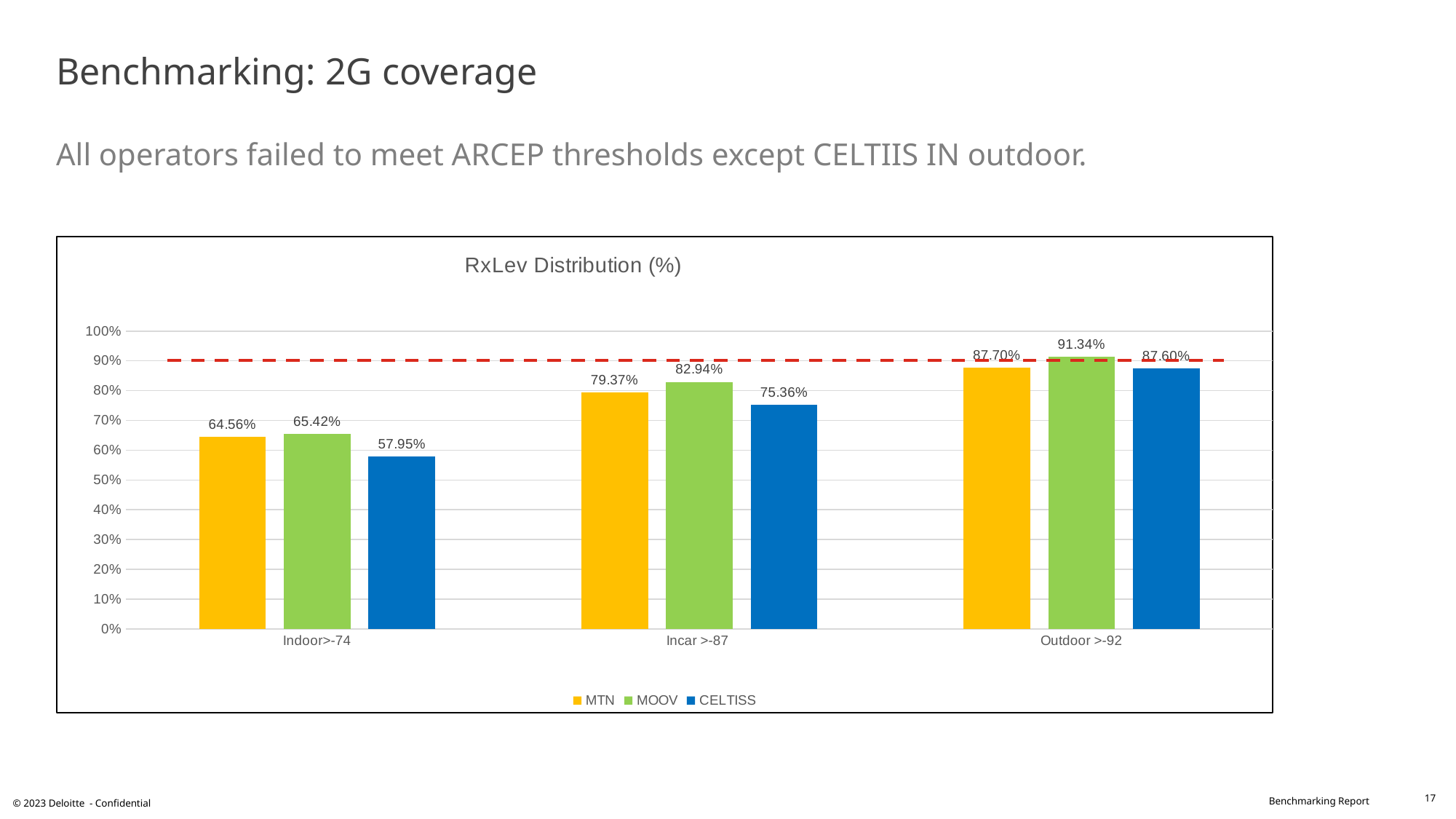
What is the value for MOOV in the Incar >-87 category? 82.94% Which is larger: the MTN value for Incar >-87 or the MTN value for Indoor>-74? Incar >-87 What kind of chart is shown on the slide? Bar chart What is the difference between the MOOV and CELTISS values in the Indoor>-74 category? 7.47% Which operator has the lowest value in the Incar >-87 category? CELTISS How many categories are shown on the x axis? 3 Is the value for MOOV in the Outdoor >-92 category greater or less than 90%? greater What is the value for CELTISS in the Indoor>-74 category? 57.95% How many series does the legend list? 3 What is the value for MTN in the Outdoor >-92 category? 87.70% What is the title of the chart? RxLev Distribution (%) Which operator has the highest value in the Outdoor >-92 category? MOOV